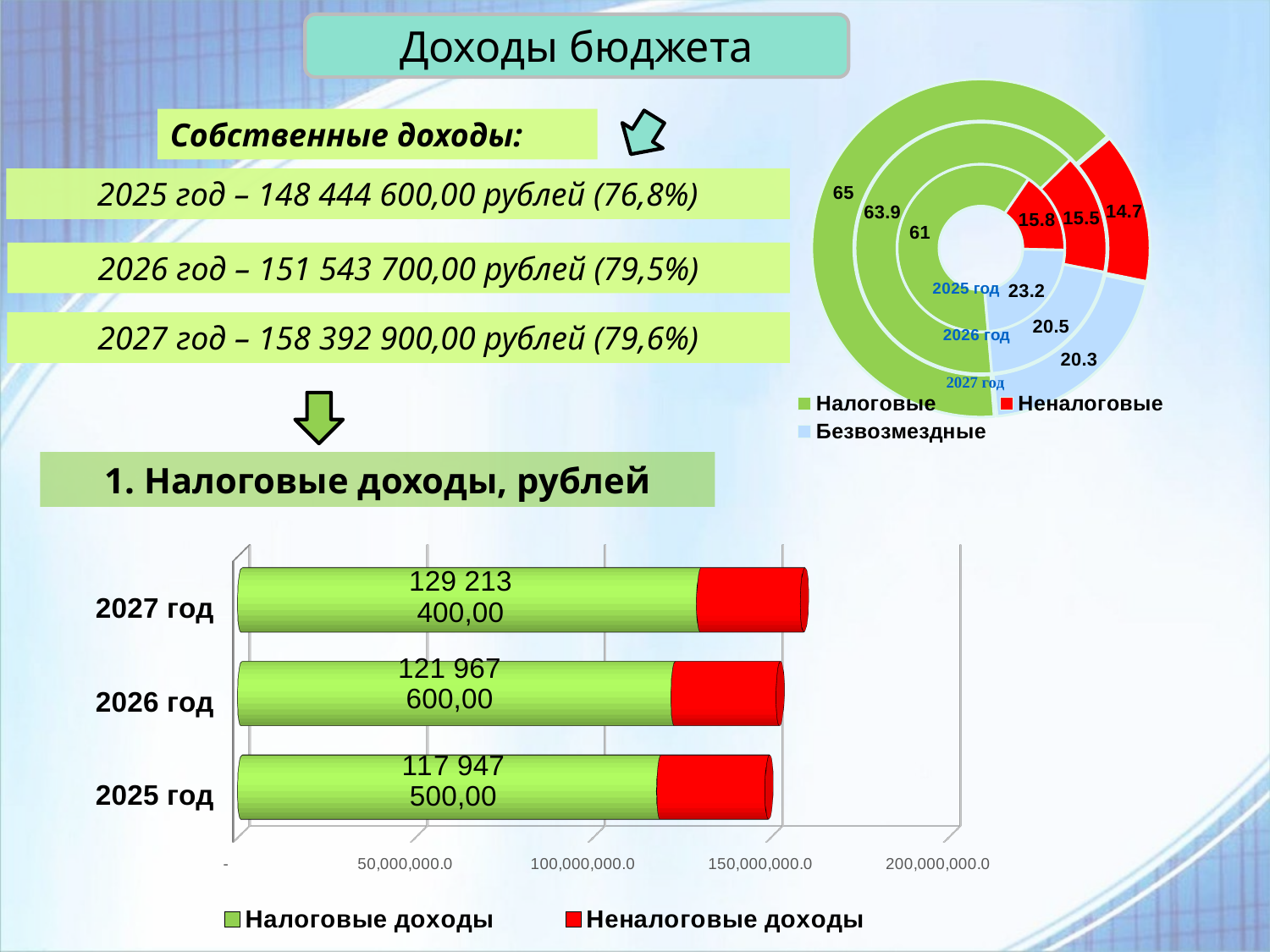
In the doughnut chart at the top right, what is the value for Безвозмездные in 2025 год? 23.2 In the bottom bar chart, is the total length of the bar for 2027 год greater or less than 150,000,000.0? greater In the bottom bar chart, what is the value of Налоговые доходы for 2027 год? 129 213 400,00 How many years (categories) are shown in the bottom bar chart? 3 In the doughnut chart at the top right, does the Налоговые value rise or fall from 2025 год to 2027 год? rise What kind of chart is the chart at the bottom of the slide titled "1. Налоговые доходы, рублей"? bar chart In the bottom bar chart, which year has the highest Налоговые доходы? 2027 год In the doughnut chart at the top right, what is the value for Налоговые in 2027 год? 65 How many series does the legend of the bottom bar chart list? 2 In the bottom bar chart, which year has the lowest Налоговые доходы? 2025 год In the bottom bar chart, what is the value of Налоговые доходы for 2025 год? 117 947 500,00 In the bottom bar chart, what is the difference between Налоговые доходы for 2027 год and 2026 год? 7 245 800,00